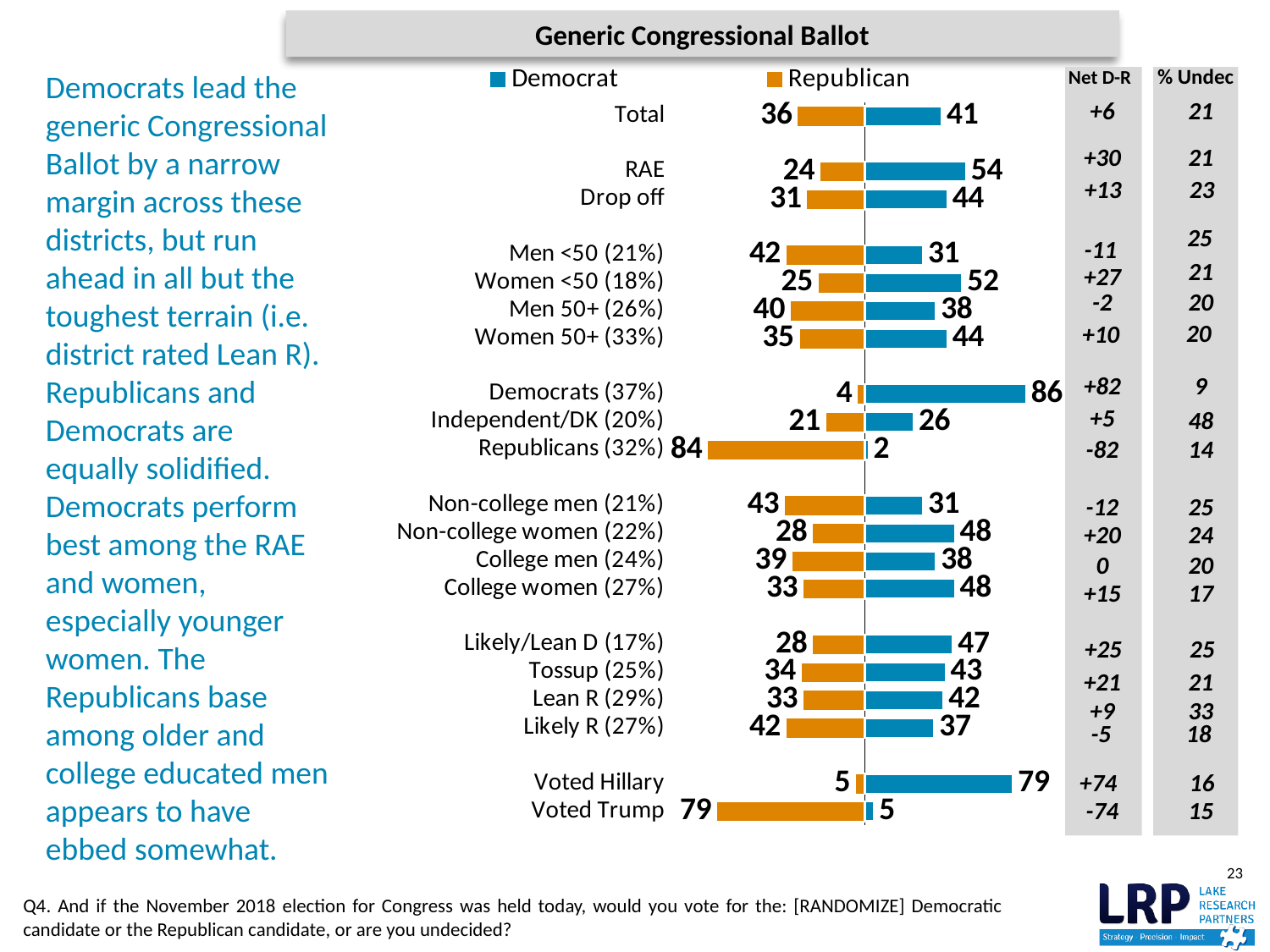
Which category has the lowest Republican value? Democrats (37%) Which category has the highest Democrat value? Democrats (37%) What is the Republican value for Men <50 (21%)? 42 What is the title of the chart? Generic Congressional Ballot For Women <50 (18%), which is larger, the Democrat value or the Republican value? Democrat What is the Democrat value for Voted Hillary? 79 How many categories are plotted in the chart? 20 Which colour represents the Republican series in the chart? Orange What is the Democrat value for Total? 41 What kind of chart is shown on the slide? Bar chart What is the difference between the Democrat and Republican values for RAE? 30 How many series does the legend list? 2